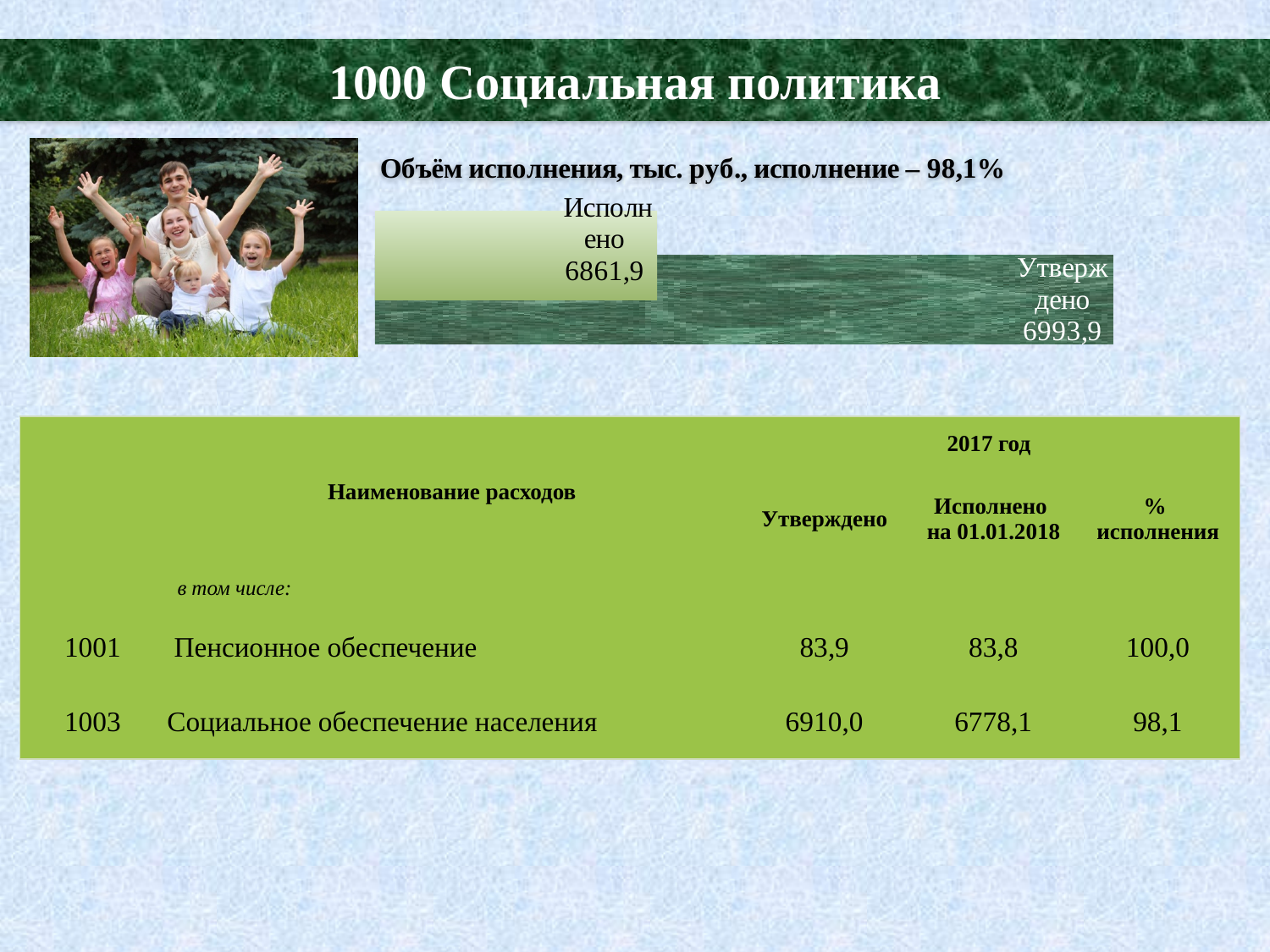
What kind of chart is shown on the slide? bar chart What is the difference between the Утверждено and Исполнено values in the chart? 132,0 How many bars are shown in the chart? 2 Which bar in the chart has the lower value? Исполнено What is the value of the Утверждено bar in the chart? 6993,9 Which bar in the chart has the higher value? Утверждено Is the Исполнено value larger or smaller than the Утверждено value in the chart? smaller What unit is stated in the chart title for the values? тыс. руб. What is the title of the chart? Объём исполнения, тыс. руб., исполнение – 98,1% Which bar in the chart is shown in light green? Исполнено What is the value of the Исполнено bar in the chart? 6861,9